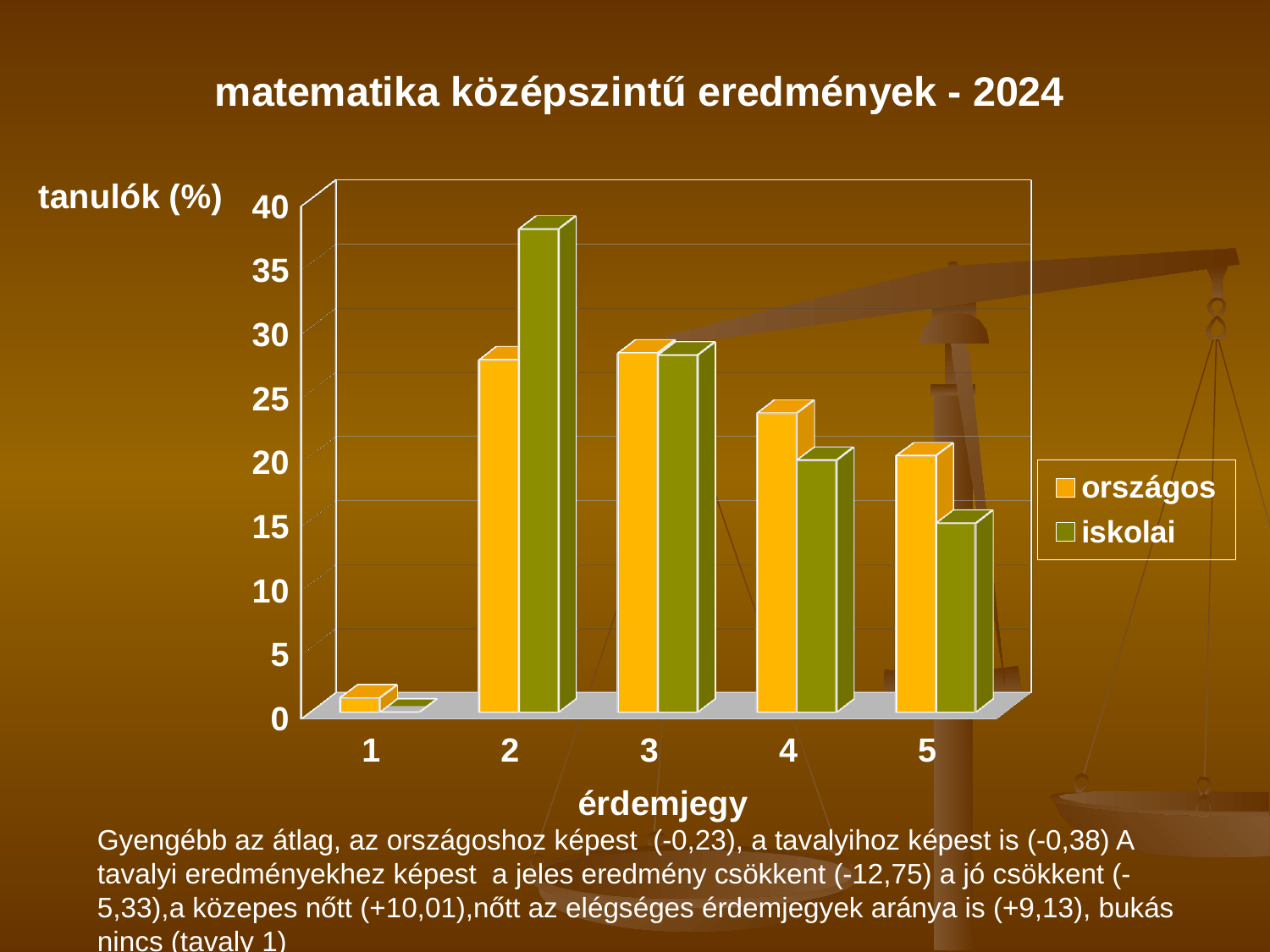
What kind of chart is shown on the slide? bar chart Is the iskolai value for grade 5 greater or less than 20? less How many grade categories (érdemjegy) are shown on the x axis? 5 For grade 5, which is larger: the országos value or the iskolai value? országos For which grade is the országos value lowest? 1 For which grade is the iskolai value highest? 2 For grade 2, which is larger: the országos value or the iskolai value? iskolai What is the label of the vertical axis? tanulók (%) Is the országos value for grade 1 greater or less than 5? less Is the iskolai value for grade 2 greater or less than 35? greater What are the two series named in the legend? országos and iskolai How many series does the legend list? 2